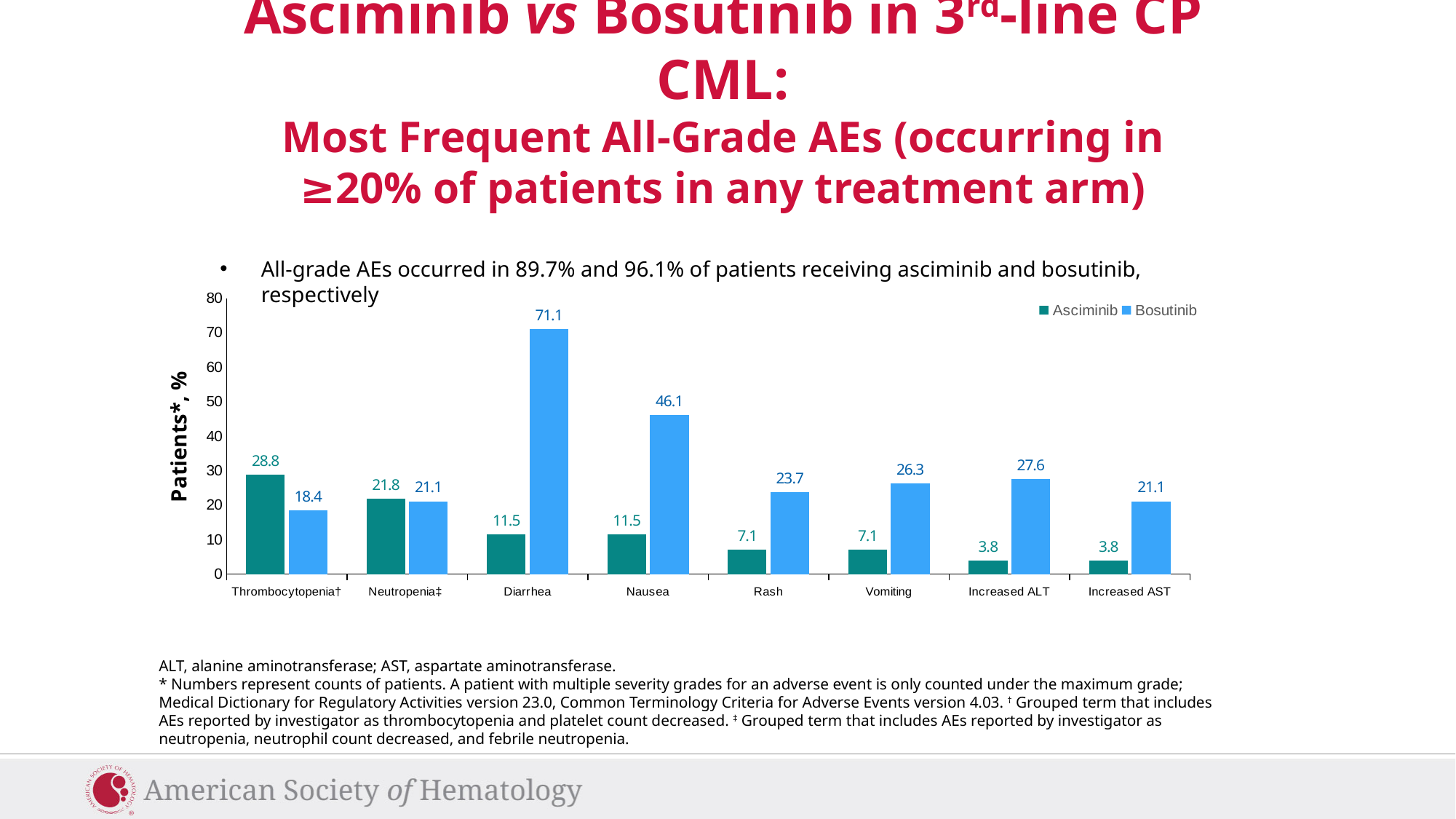
What is the Asciminib value for Increased AST? 3.8 Which adverse event has the lowest Bosutinib value? Thrombocytopenia† How many adverse event categories are shown on the x axis? 8 What kind of chart is shown on the slide? Bar chart How many series does the legend list? 2 Which adverse event has the highest Bosutinib value? Diarrhea What is the Bosutinib value for Diarrhea? 71.1 What is the difference between the Bosutinib and Asciminib values for Diarrhea? 59.6 For Thrombocytopenia, which is larger: the Asciminib value or the Bosutinib value? Asciminib What is the Bosutinib value for Nausea? 46.1 What is the y-axis label of the chart? Patients*, % What is the Asciminib value for Thrombocytopenia? 28.8